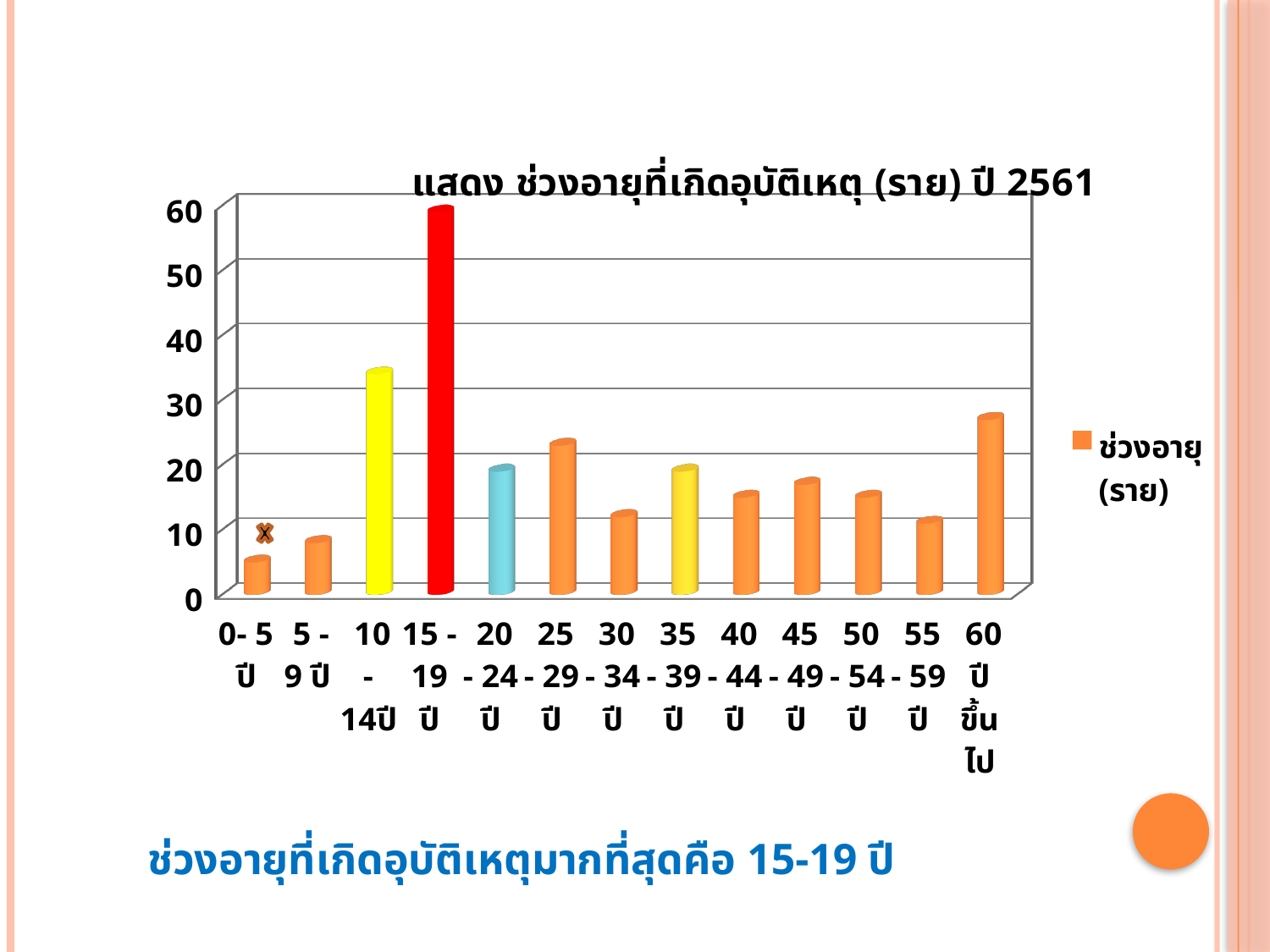
What kind of chart is shown on the slide? bar chart How many series does the legend list? 1 Which age group has the lowest number of accidents in the chart? 0- 5 ปี What is the title of the chart? แสดง ช่วงอายุที่เกิดอุบัติเหตุ (ราย) ปี 2561 Is the value for 0- 5 ปี greater or less than 10? less Which has a larger value, 10 - 14ปี or 60 ปีขึ้นไป? 10 - 14ปี Is the value for 60 ปีขึ้นไป greater or less than 20? greater Is the value for 10 - 14ปี greater or less than 30? greater Which age group has the highest number of accidents in the chart? 15 - 19 ปี How many age-group categories are shown on the x axis? 13 Which has a larger value, 25 - 29 ปี or 30 - 34 ปี? 25 - 29 ปี